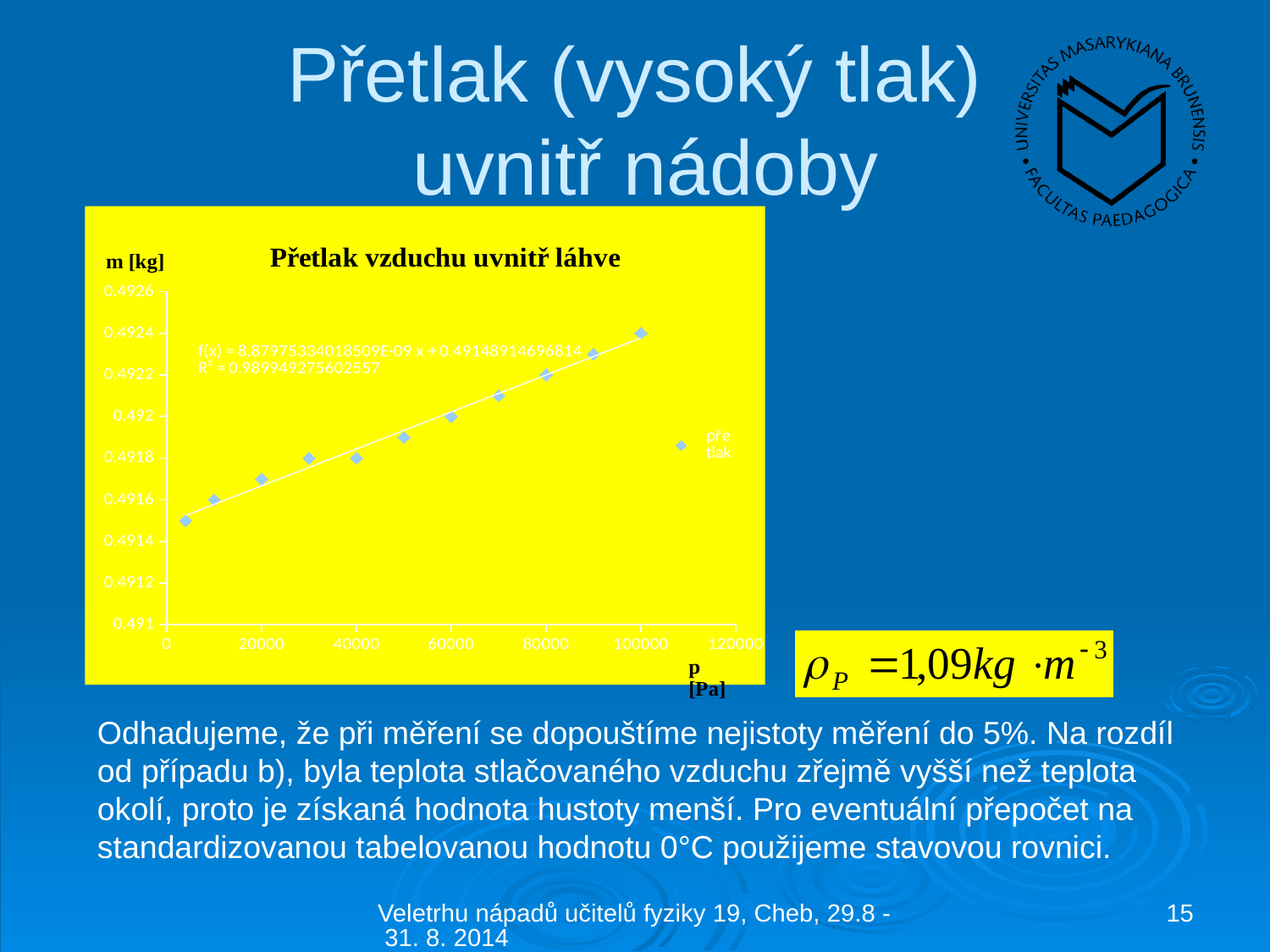
At which pressure value is the highest mass m recorded? 100000 How many data points are plotted in the chart? 11 Is the value of m for the leftmost data point greater or less than 0.4916? less What is the title of the chart? Přetlak vzduchu uvnitř láhve What kind of chart is shown on the slide? scatter chart Do the plotted values rise or fall as pressure p increases along the x axis? rise Which has the larger value of m: the point at p = 80000 Pa or the point at p = 20000 Pa? p = 80000 Pa What R² value is printed on the chart for the trendline? 0.989949275602557 Is the value of m at p = 60000 Pa greater or less than 0.4918? greater How many series does the chart legend list? 1 Is the value of m at p = 100000 Pa greater or less than 0.4922? greater What is the label of the vertical axis of the chart? m [kg]